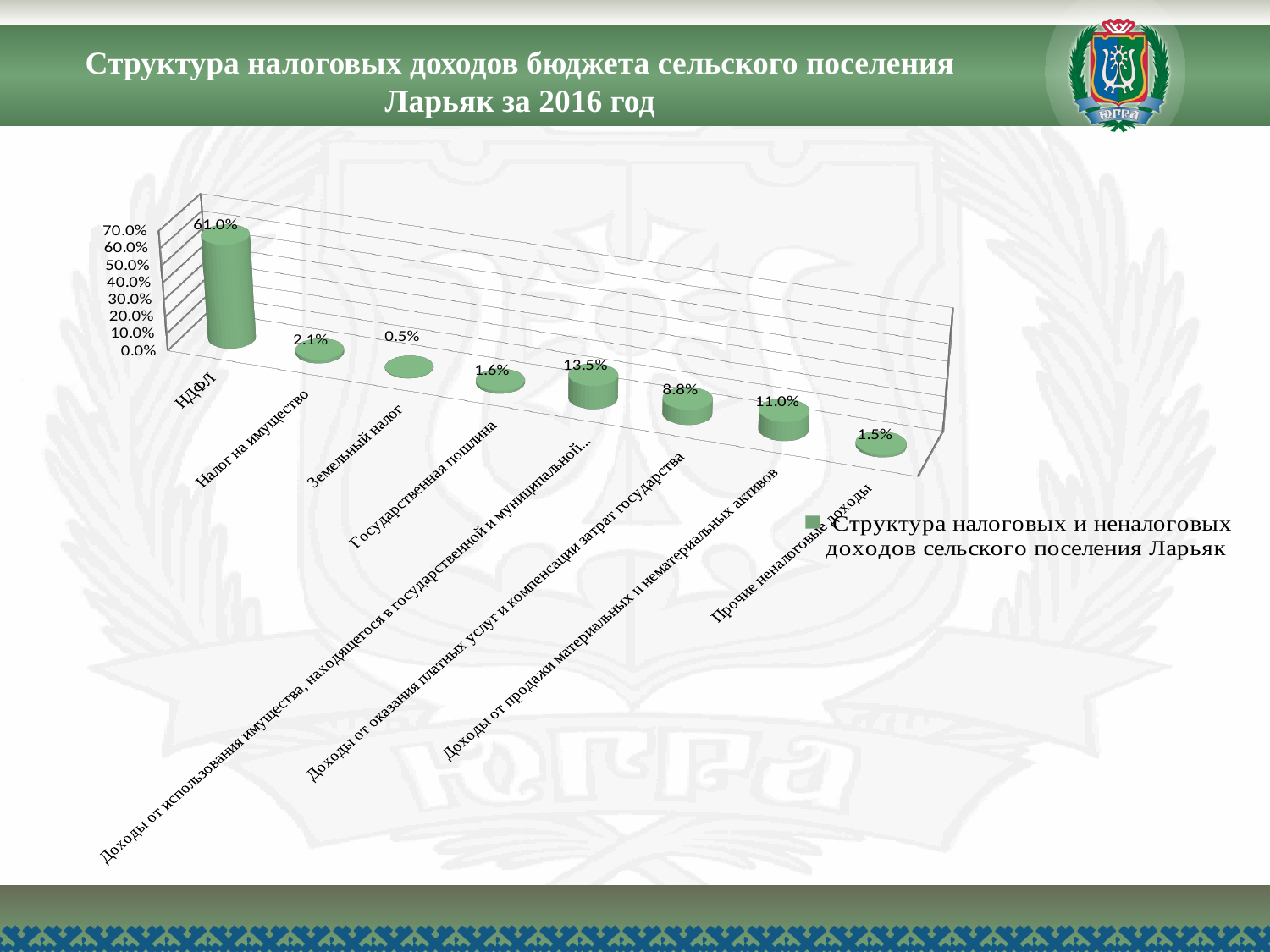
Which category has the lowest value? Земельный налог Which is larger: the value for Доходы от оказания платных услуг и компенсации затрат государства or the value for Доходы от продажи материальных и нематериальных активов? Доходы от продажи материальных и нематериальных активов Is the value for НДФЛ greater or less than 50.0%? greater What is the value for Доходы от продажи материальных и нематериальных активов? 11.0% How many series does the legend list? 1 Which category has the highest value? НДФЛ What is the value for НДФЛ? 61.0% What is the value for Земельный налог? 0.5% What is the value for Прочие неналоговые доходы? 1.5% What is the difference between the values for Налог на имущество and Государственная пошлина? 0.5% What kind of chart is shown on the slide? bar chart How many categories are shown on the chart? 8